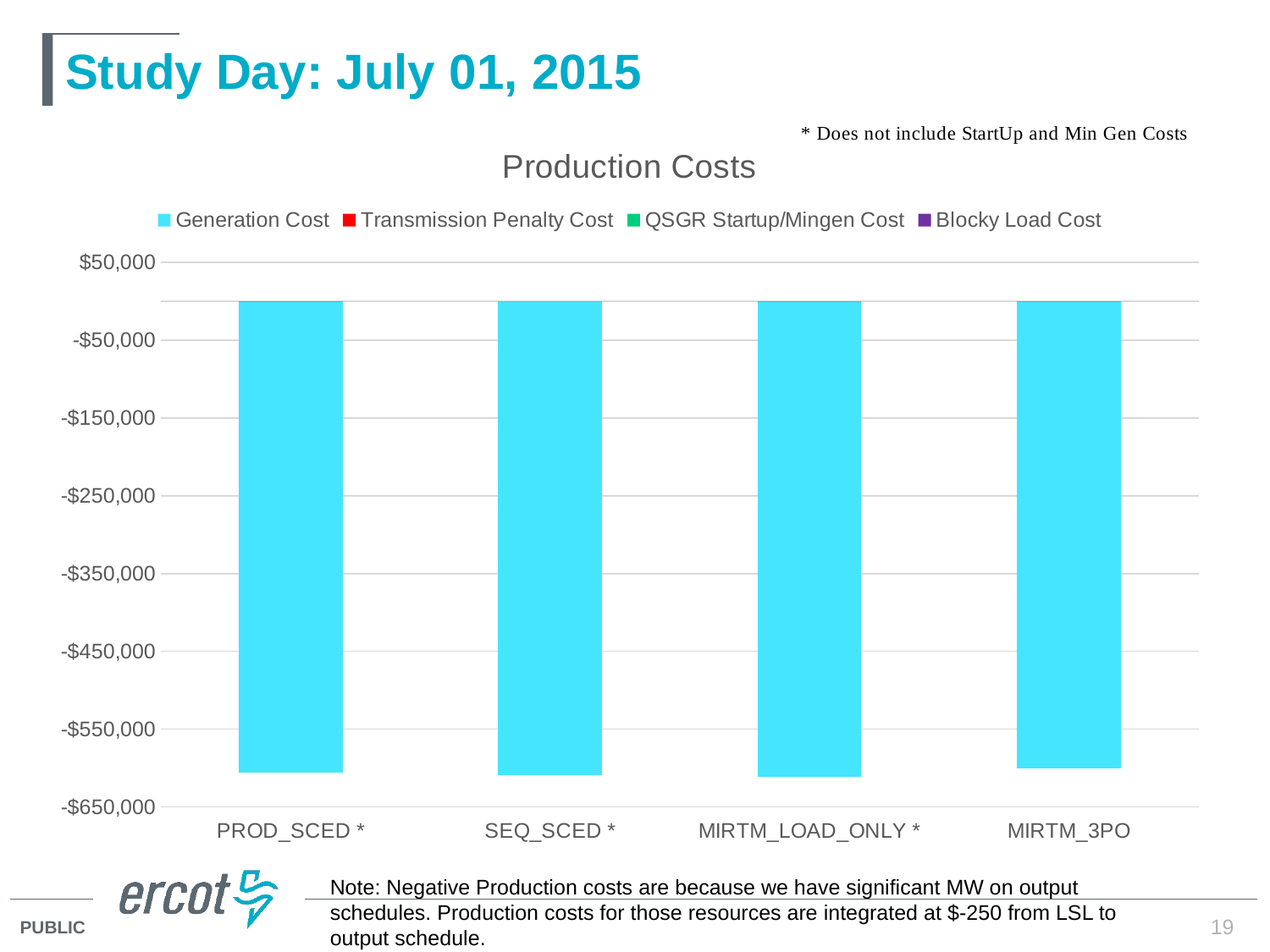
How many categories are shown on the x axis? 4 How many series does the legend list? 4 Is the Generation Cost value for MIRTM_3PO greater or less than -$450,000? less What is the label of the first category on the x axis? PROD_SCED * Which series is shown in light blue in the legend? Generation Cost Is the Generation Cost value for SEQ_SCED * greater or less than $50,000? less Is the Generation Cost value for SEQ_SCED * greater or less than -$650,000? greater What is the title of the chart? Production Costs What kind of chart is shown on the slide? bar chart